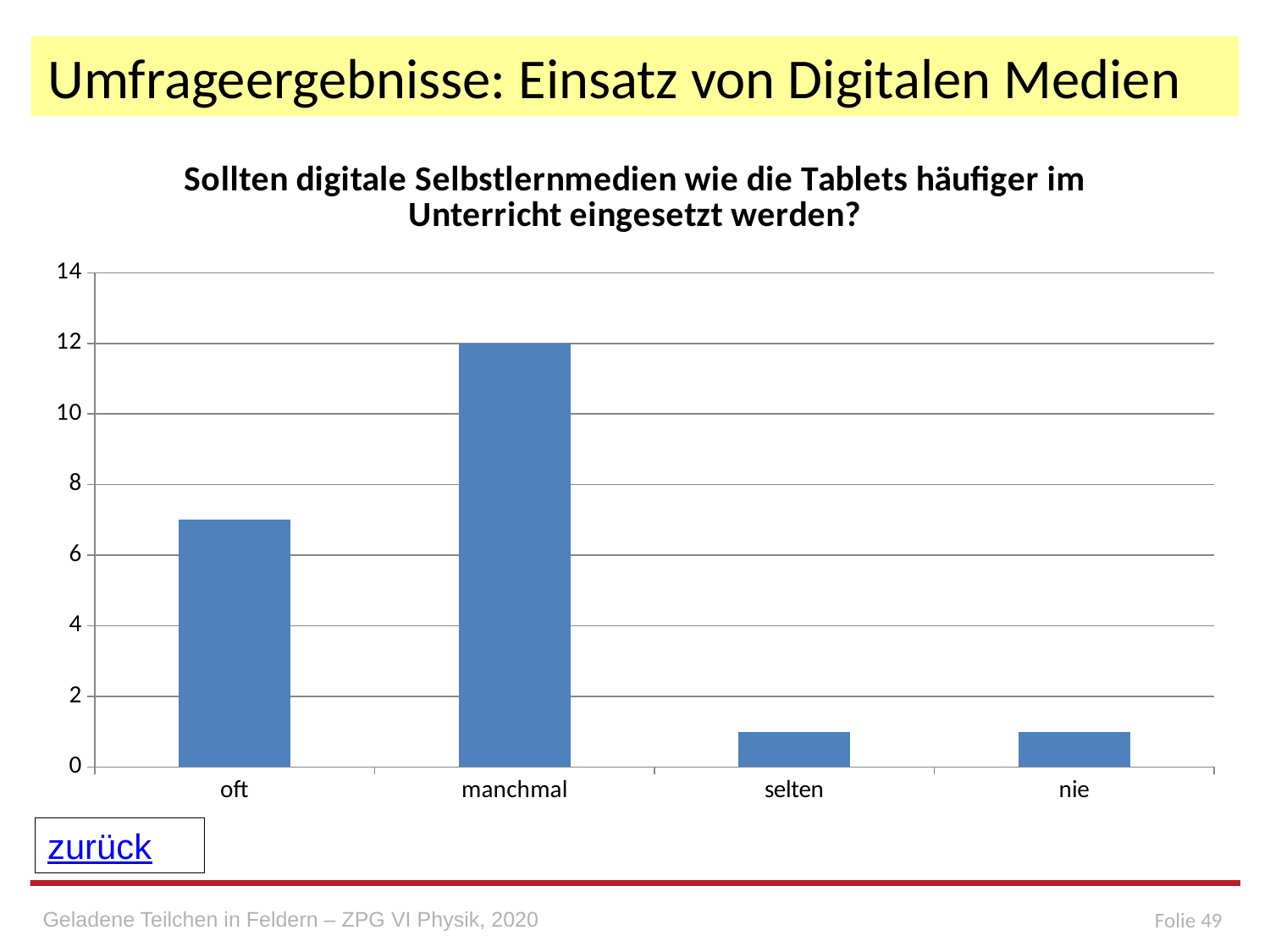
Is the value for "selten" greater or less than 2? less Which is larger, the value for "oft" or the value for "manchmal"? manchmal What is the value for "manchmal" in the chart? 12 Which is larger, the value for "oft" or the value for "selten"? oft What kind of chart is shown on the slide? bar chart How many categories are shown on the x axis of the chart? 4 Is the value for "oft" greater or less than 8? less Which category has the highest value in the chart? manchmal What is the title of the chart? Sollten digitale Selbstlernmedien wie die Tablets häufiger im Unterricht eingesetzt werden? Is the value for "nie" greater or less than 2? less What is the highest value shown on the y axis of the chart? 14